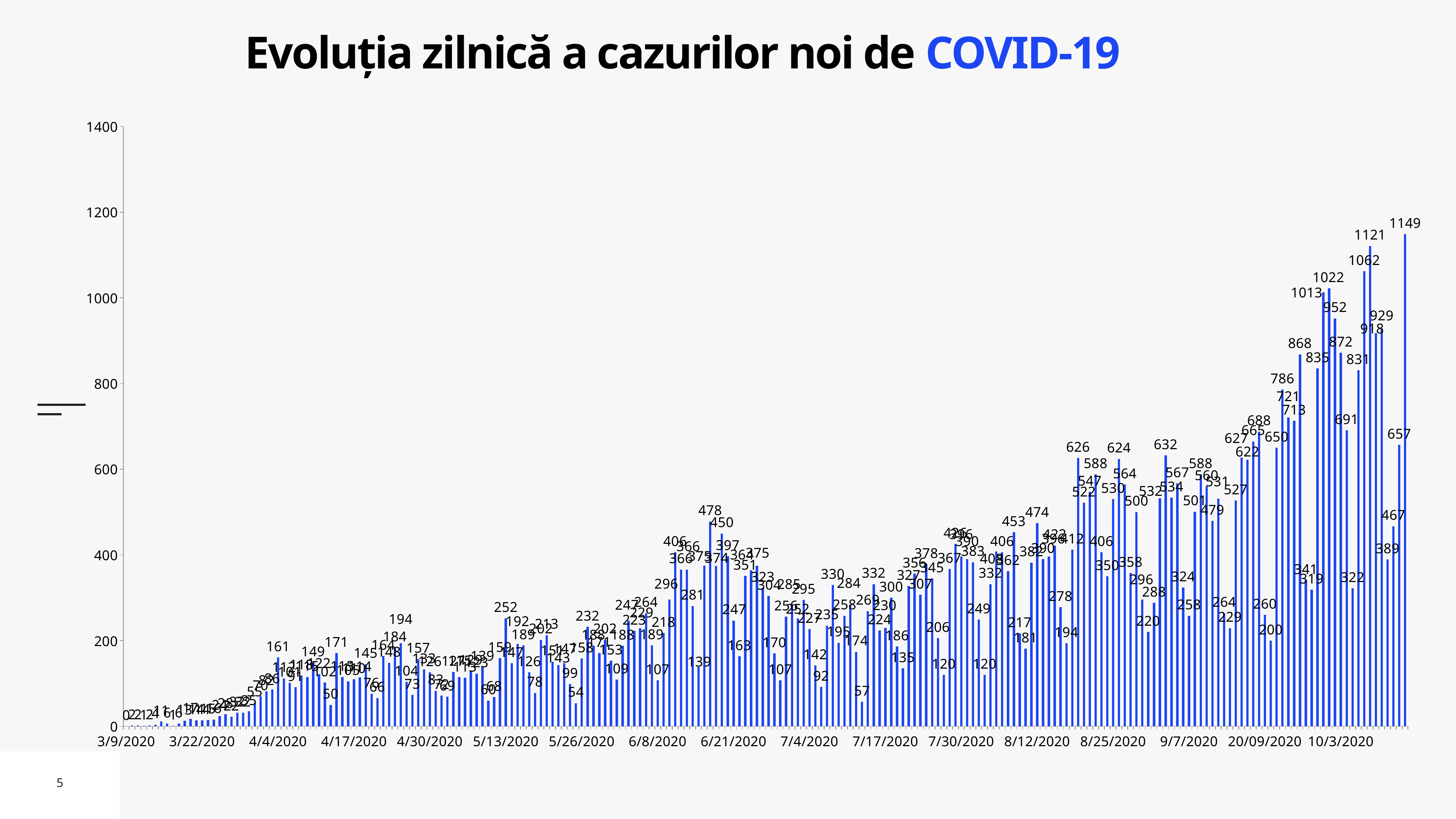
What is the value of the rightmost (last) bar on the chart? 1149 What kind of chart is shown on the slide? bar chart What is the first date label on the x axis? 3/9/2020 What is the difference between the two highest labelled values, 1149 and 1121? 28 What is the second-highest value labelled on the chart? 1121 Is the value of the last bar on the chart greater or less than 1000? greater Overall, do the daily values rise or fall from left to right along the x axis? rise Which is larger, the bar labelled 1121 or the bar labelled 1062? 1121 What is the title of the chart? Evoluția zilnică a cazurilor noi de COVID-19 Are the bars near 3/9/2020 greater or less than 200? less What is the maximum value shown on the vertical axis? 1400 What is the highest value labelled on the chart? 1149